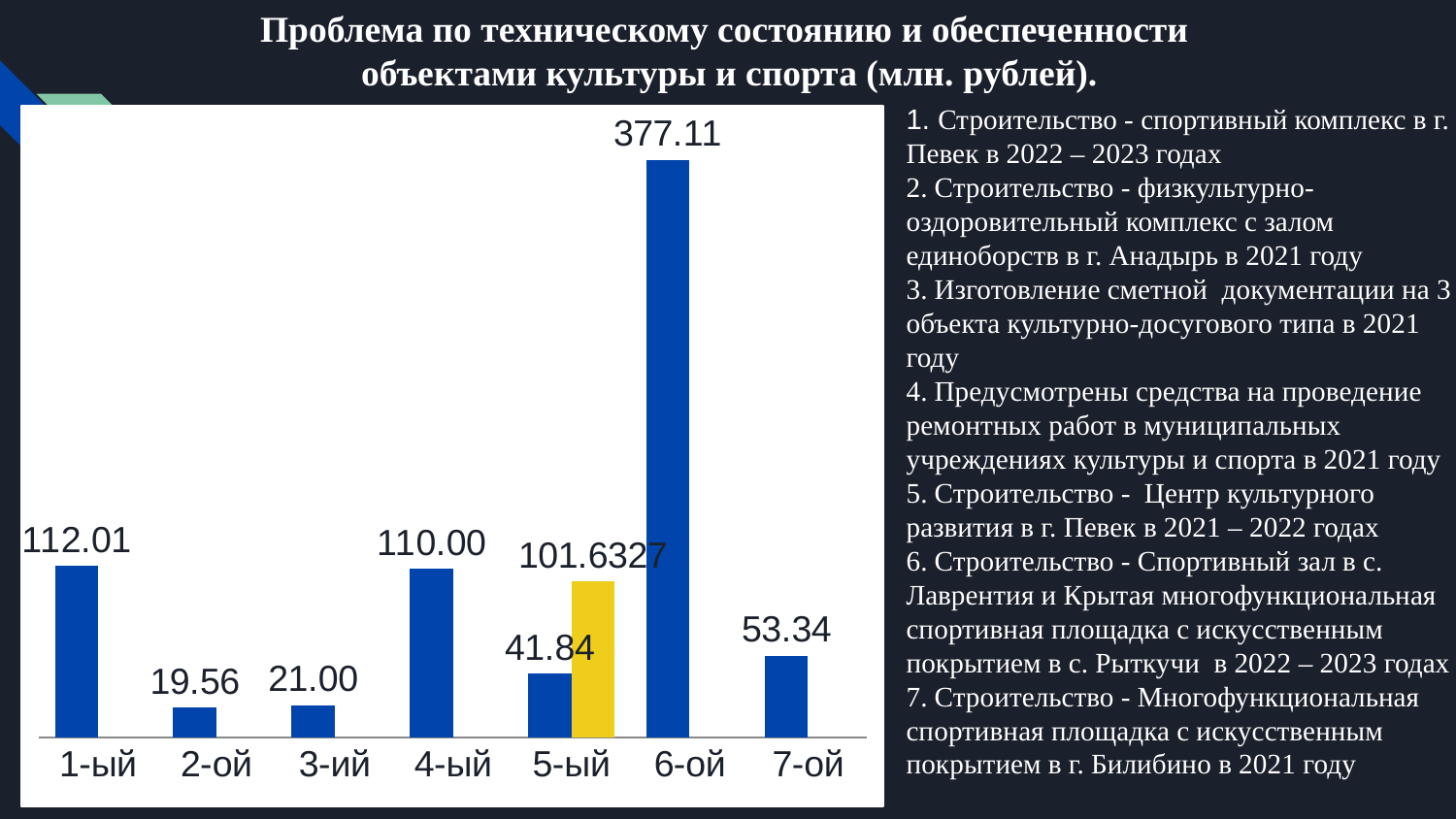
How many categories are shown on the x axis? 7 Which is larger, the value for 7-ой or the value for 3-ий? 7-ой What is the value for the 6-ой category? 377.11 What is the value for the 1-ый category? 112.01 What is the value of the yellow bar in the 5-ый category? 101.6327 What is the difference between the values for 1-ый and 4-ый? 2.01 What kind of chart is shown on the slide? bar chart What is the difference between the values for 3-ий and 2-ой? 1.44 What is the value for the 7-ой category? 53.34 Which category has the lowest value? 2-ой What is the value of the blue bar in the 5-ый category? 41.84 Which category has the highest value? 6-ой